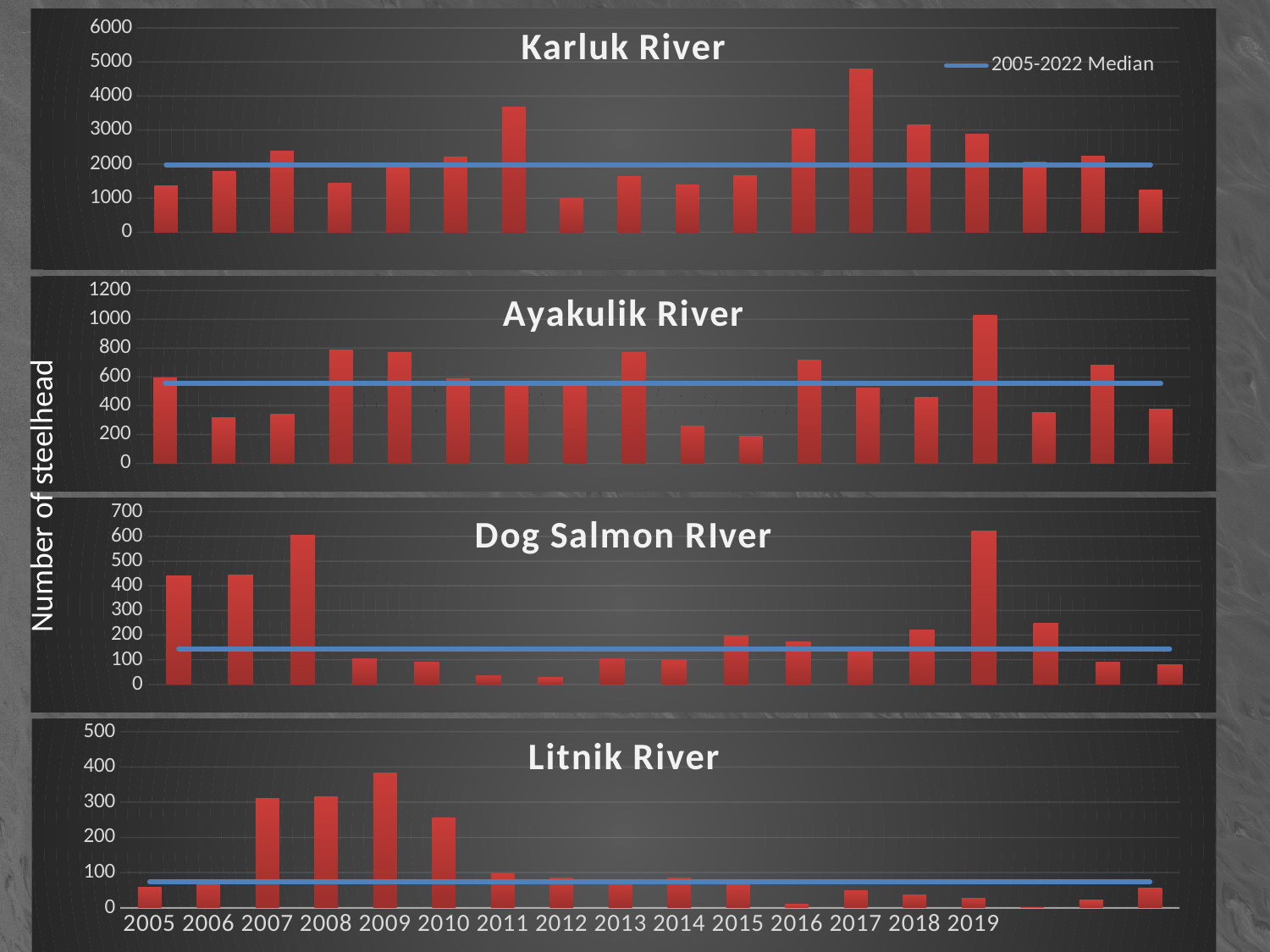
In the Litnik River chart, which year has the highest bar? 2009 In the Ayakulik River chart, is the value for 2015 greater or less than 400? less In the Karluk River chart, is the value for 2011 greater or less than 3000? greater What kind of chart is the Litnik River chart? combination bar and line chart In the Ayakulik River chart, which year has the highest bar? 2019 In the Litnik River chart, which is larger, the value for 2009 or the value for 2010? 2009 In the Karluk River chart, is the value for 2017 greater or less than 4000? greater What does the legend entry on the Karluk River chart say? 2005-2022 Median In the Karluk River chart, which year has the highest bar? 2017 In the Ayakulik River chart, which is larger, the value for 2008 or the value for 2006? 2008